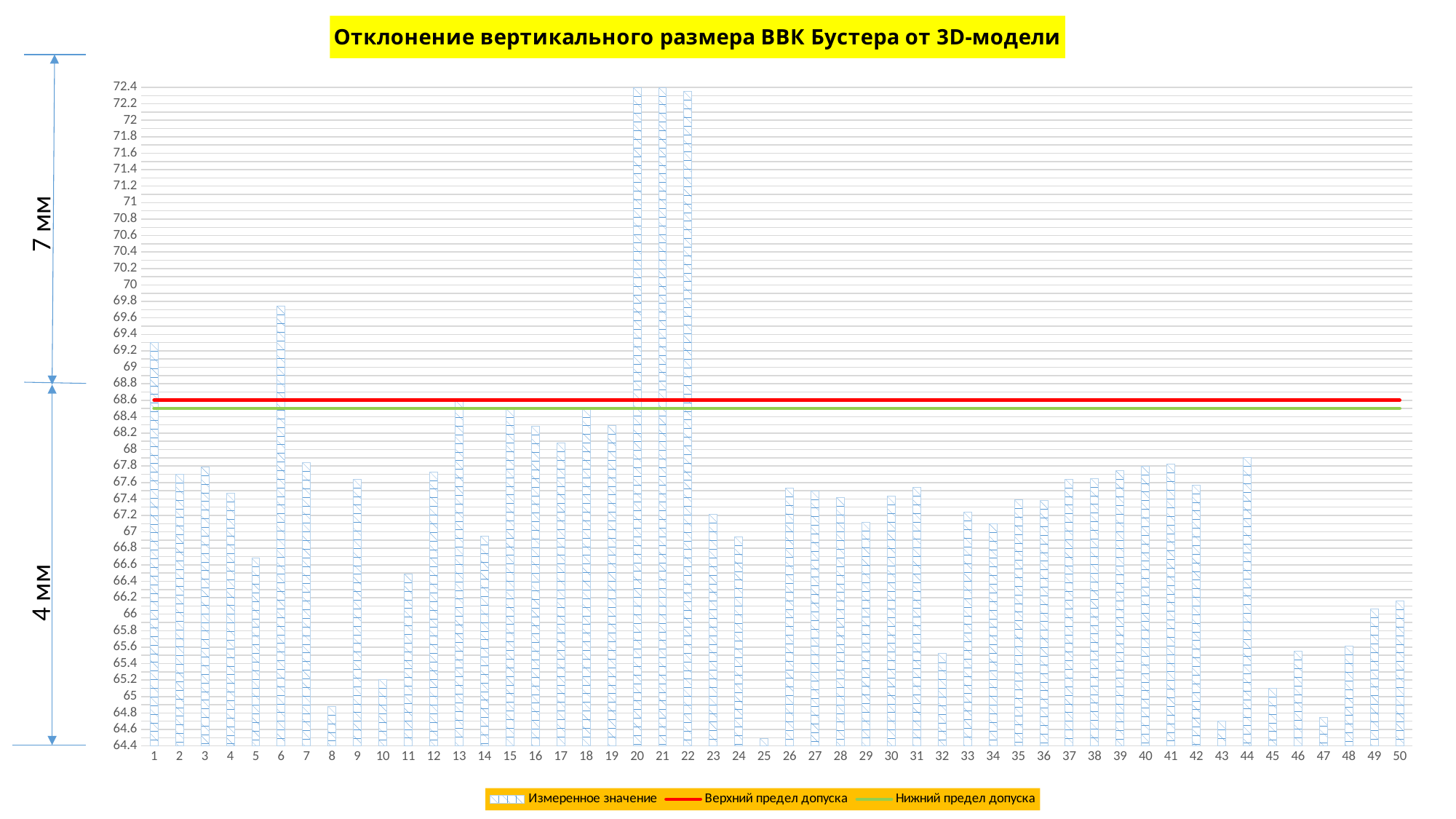
Is the measured value for point 32 greater or less than 66? less Is the measured value for point 8 greater or less than 65? less Is the measured value for point 6 greater or less than 69? greater Which has the larger measured value, point 1 or point 6? point 6 Which colour is used for the line labelled 'Верхний предел допуска' in the legend? red What is the title of the chart? Отклонение вертикального размера ВВК Бустера от 3D-модели How many measurement points (categories) are plotted along the x axis? 50 What kind of chart is shown on the slide? combination bar and line chart How many series does the legend list? 3 Which has the larger measured value, point 8 or point 9? point 9